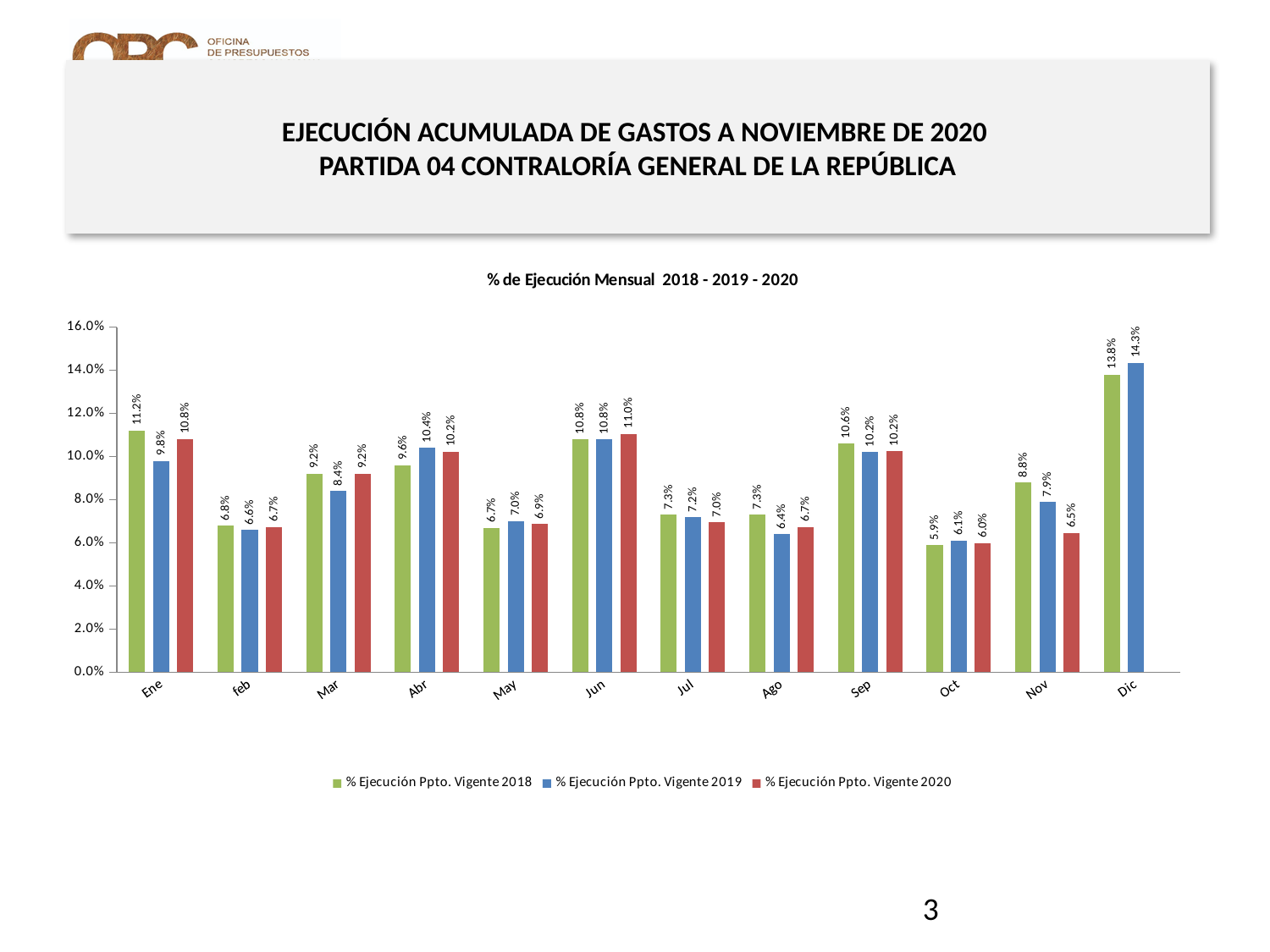
What is the difference between the 2018 and 2020 values in Nov? 2.3% What is the title of the chart? % de Ejecución Mensual 2018 - 2019 - 2020 Which is larger in Abr: the 2018 value or the 2019 value? 2019 Which month has the lowest value for % Ejecución Ppto. Vigente 2018? Oct What is the difference between the 2019 and 2018 values in Dic? 0.5% How many months are shown on the x axis? 12 Which month has the highest value for % Ejecución Ppto. Vigente 2019? Dic What is the value for % Ejecución Ppto. Vigente 2019 in Nov? 7.9% What is the value for % Ejecución Ppto. Vigente 2020 in Jun? 11.0% What kind of chart is shown? Bar chart What is the value for % Ejecución Ppto. Vigente 2018 in Ene? 11.2% How many series does the legend list? 3